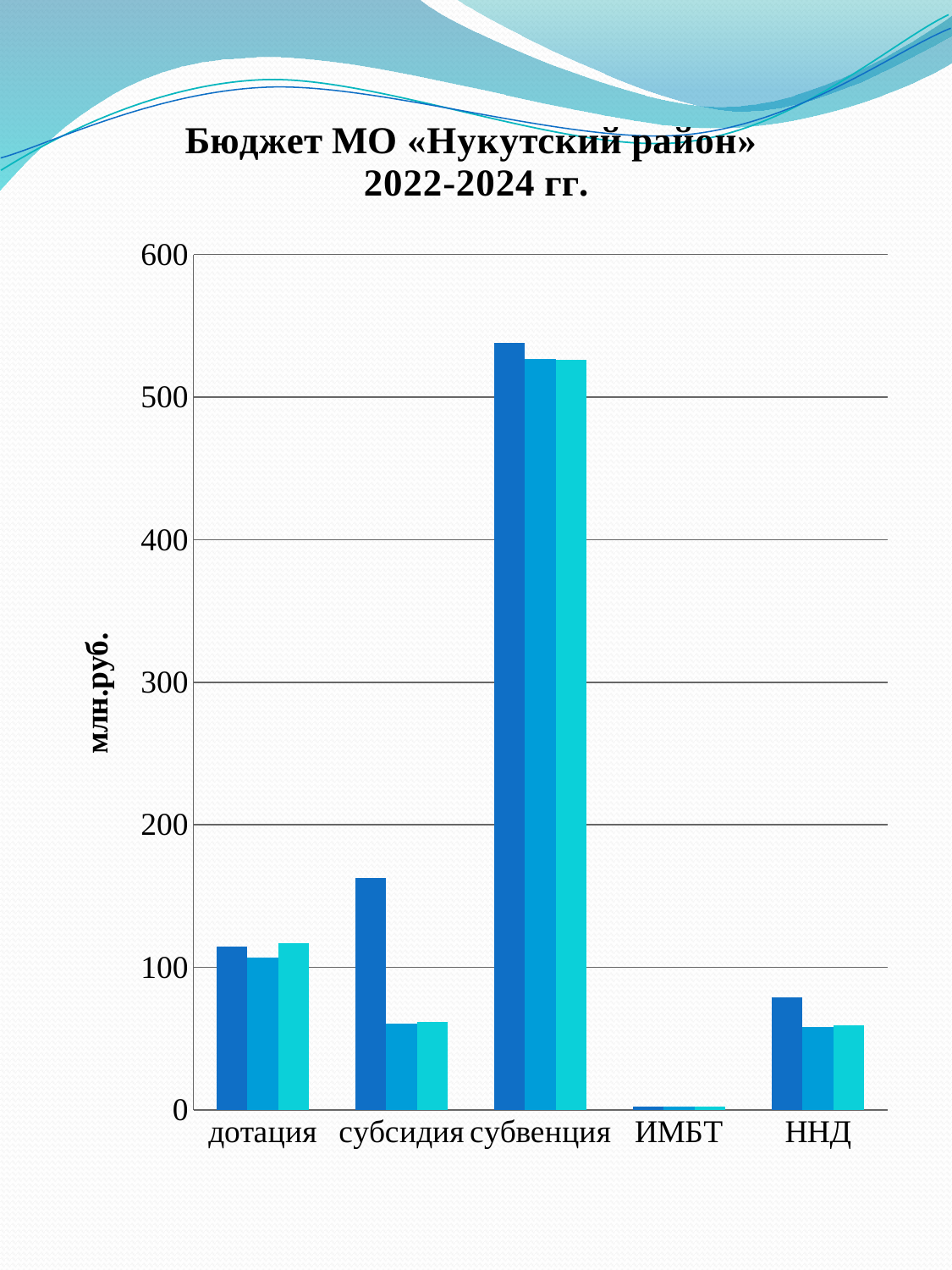
Comparing the leftmost (dark blue) bars, which is larger: дотация or ННД? дотация What is the label of the vertical axis of the chart? млн.руб. Is the value of the leftmost (dark blue) bar for ННД greater or less than 100? less What kind of chart is shown on the slide? bar chart How many bars are plotted for each category in the chart? 3 Which category has the tallest bars in the chart? субвенция How many categories are shown on the x axis of the chart? 5 Are the values for ИМБТ greater or less than 100? less What is the title of the chart? Бюджет МО «Нукутский район» 2022-2024 гг. Which category has the shortest bars in the chart? ИМБТ Is the value of the leftmost (dark blue) bar for субсидия greater or less than 150? greater